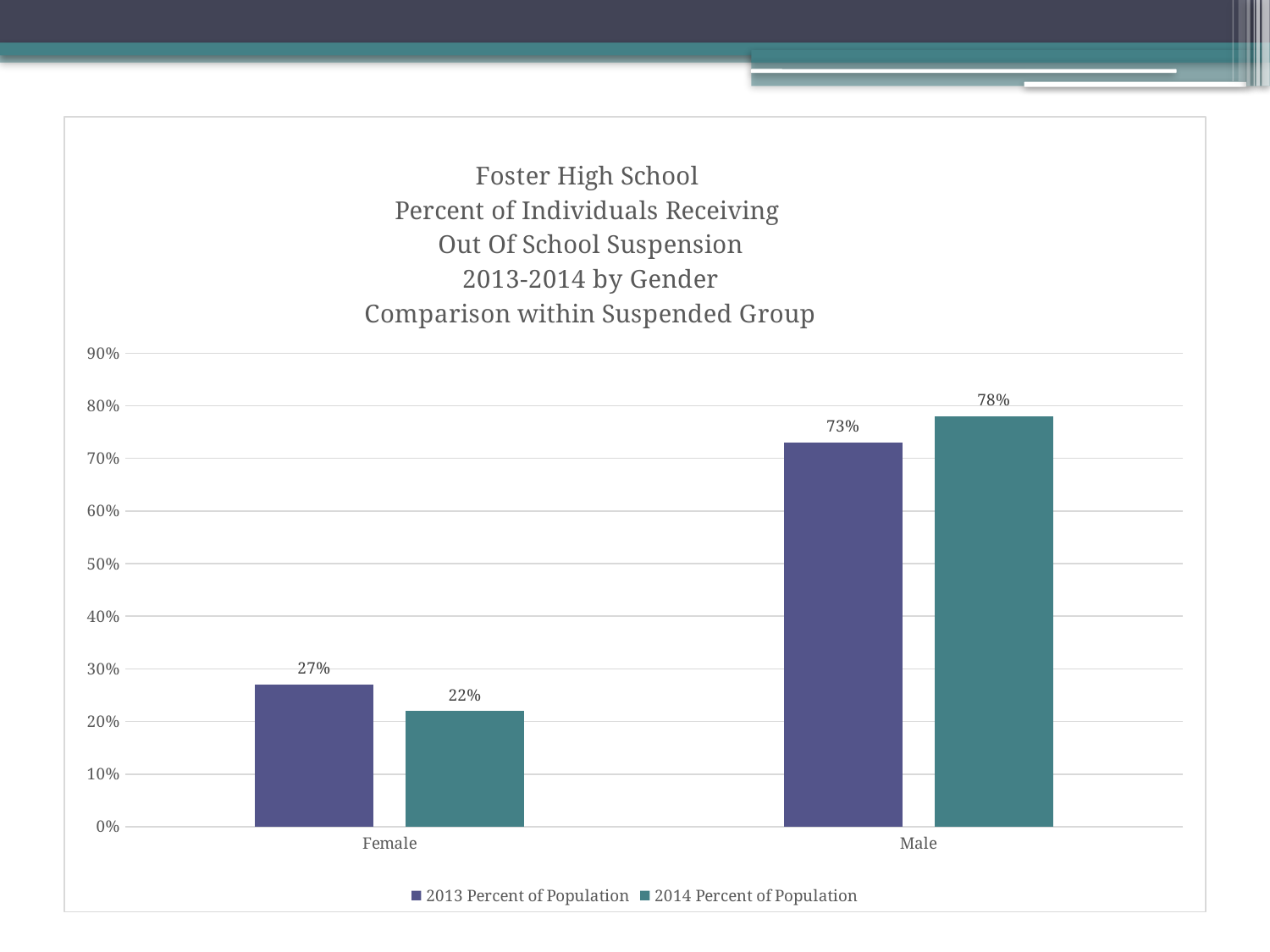
Which category has the highest 2014 Percent of Population? Male Is the 2013 Percent of Population for Male larger or smaller than the 2014 Percent of Population for Male? smaller How many series does the legend list? 2 How many categories are shown on the x axis? 2 Which category has the lowest 2013 Percent of Population? Female What is the 2013 Percent of Population for Female? 27% What kind of chart is shown on the slide? bar chart What is the 2014 Percent of Population for Male? 78% What is the 2013 Percent of Population for Male? 73% What is the 2014 Percent of Population for Female? 22% By how much did the Female value change from 2013 Percent of Population to 2014 Percent of Population? 5% What is the difference between the Male and Female values for 2013 Percent of Population? 46%